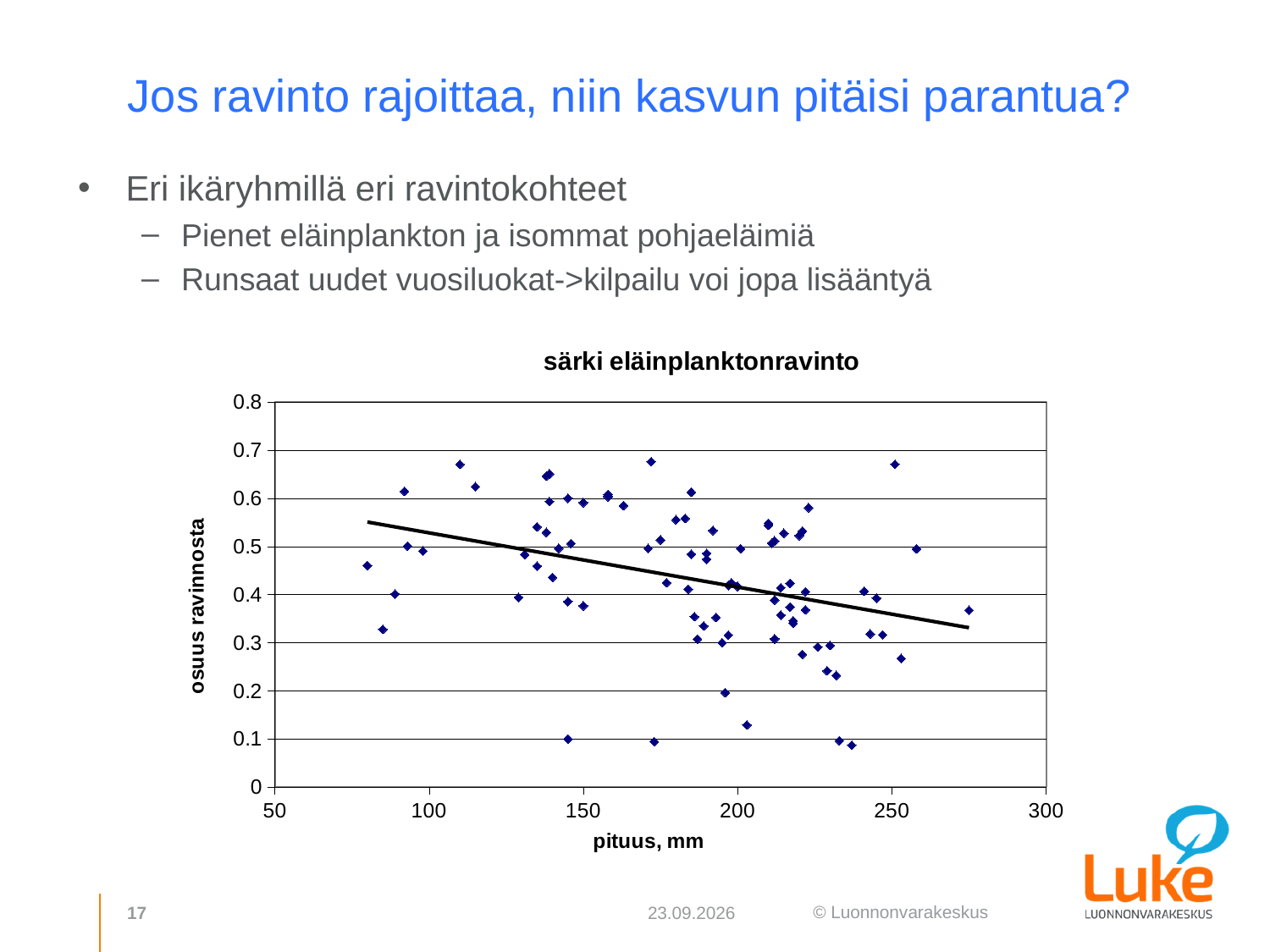
Is the value of the trend line at 200 mm greater or less than 0.5? less What kind of chart is shown on the slide? scatter chart Is the highest plotted point on the chart greater or less than 0.7? less Is the value of the trend line at 275 mm greater or less than 0.4? less Do the plotted values generally rise or fall as pituus (length) increases along the x axis? fall What is the title of the chart? särki eläinplanktonravinto What is the label of the x axis of the chart? pituus, mm Does the trend line slope upward or downward from left to right? downward